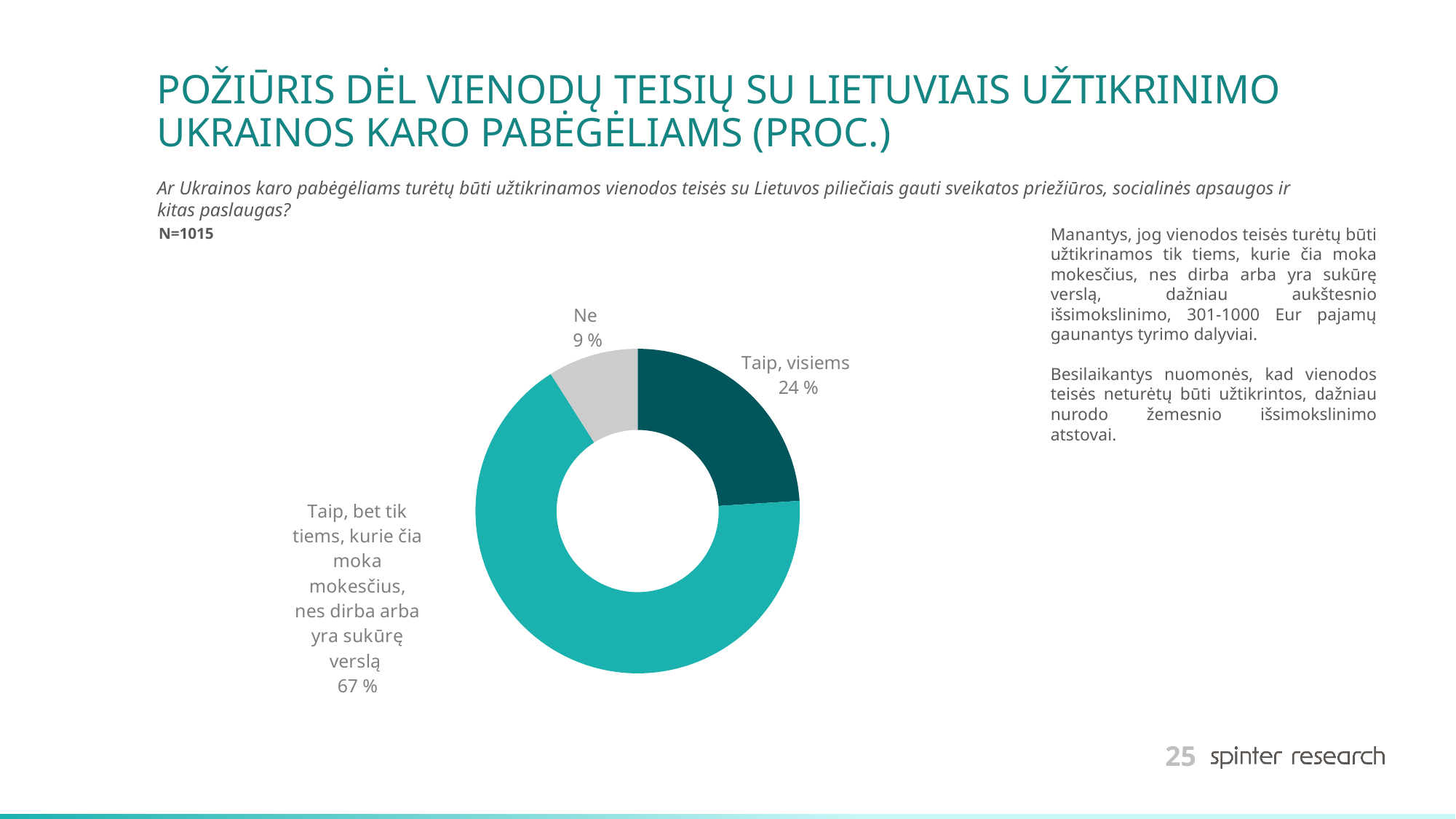
Which answer category has the largest share? Taip, bet tik tiems, kurie čia moka mokesčius, nes dirba arba yra sukūrę verslą What is the sample size (N) stated on the slide? N=1015 How many answer categories are shown in the chart? 3 What is the difference in percentage points between "Taip, visiems" and "Ne"? 15 What percentage of respondents answered "Taip, visiems"? 24 % What percentage of respondents answered "Taip, bet tik tiems, kurie čia moka mokesčius, nes dirba arba yra sukūrę verslą"? 67 % Which answer category has the smallest share? Ne What is the difference in percentage points between the largest slice and "Taip, visiems"? 43 What kind of chart is shown on the slide? Doughnut (pie) chart What percentage of respondents answered "Ne"? 9 % What colour is the "Ne" slice of the chart? Light grey Which is larger, the share for "Taip, visiems" or the share for "Ne"? Taip, visiems